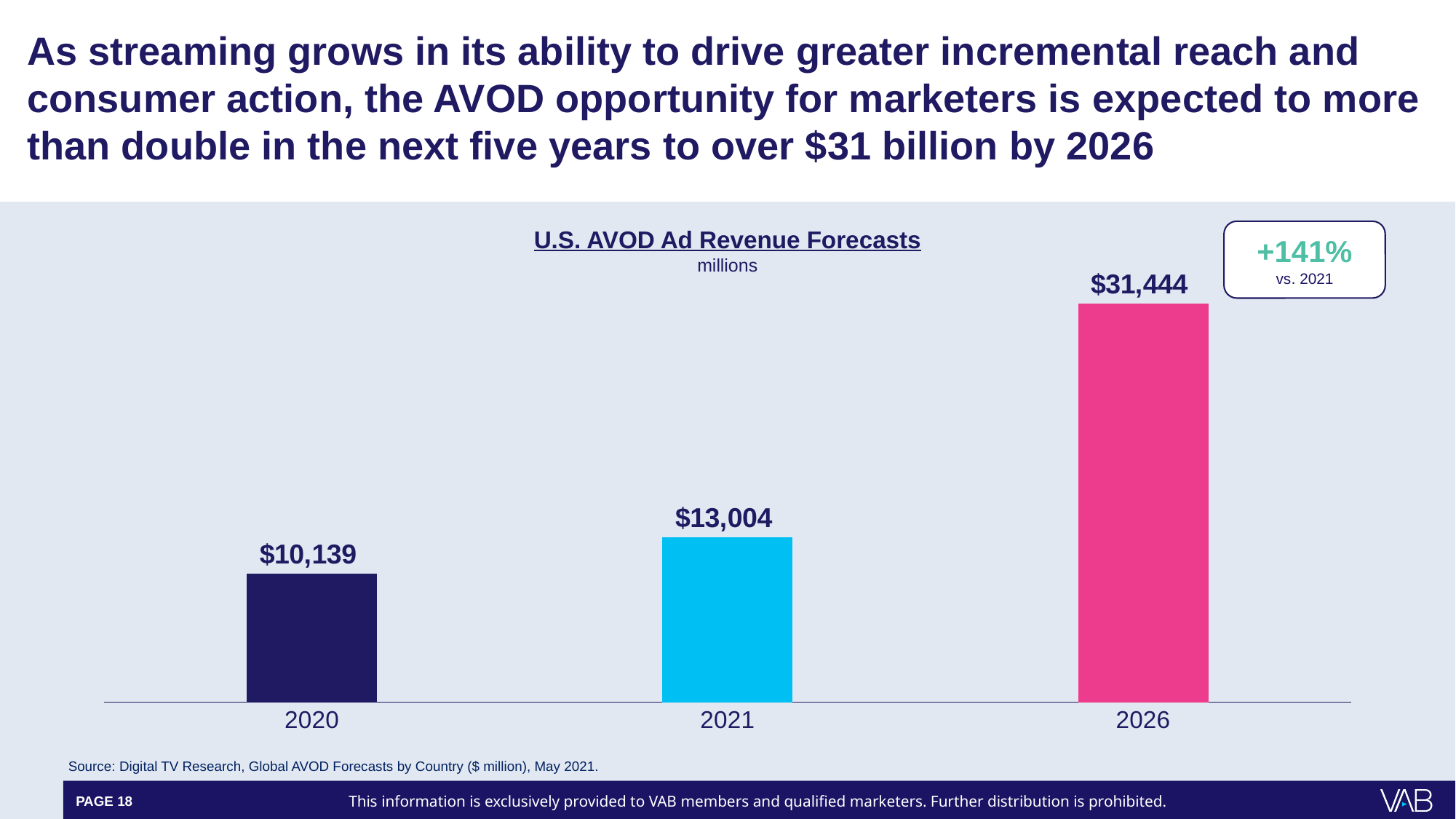
What is the U.S. AVOD ad revenue forecast shown for 2026? $31,444 How many years are plotted on the chart? 3 What is the U.S. AVOD ad revenue value shown for 2021? $13,004 Do the values rise or fall from 2020 to 2026 along the x axis? Rise What is the difference between the 2026 and 2021 values on the chart? $18,440 Which year has the highest U.S. AVOD ad revenue value on the chart? 2026 Which is larger, the value for 2020 or the value for 2021? 2021 What is the title of the chart? U.S. AVOD Ad Revenue Forecasts Which year has the lowest U.S. AVOD ad revenue value on the chart? 2020 What is the U.S. AVOD ad revenue value shown for 2020? $10,139 What kind of chart is shown on the slide? Bar chart What is the difference between the 2021 and 2020 values on the chart? $2,865